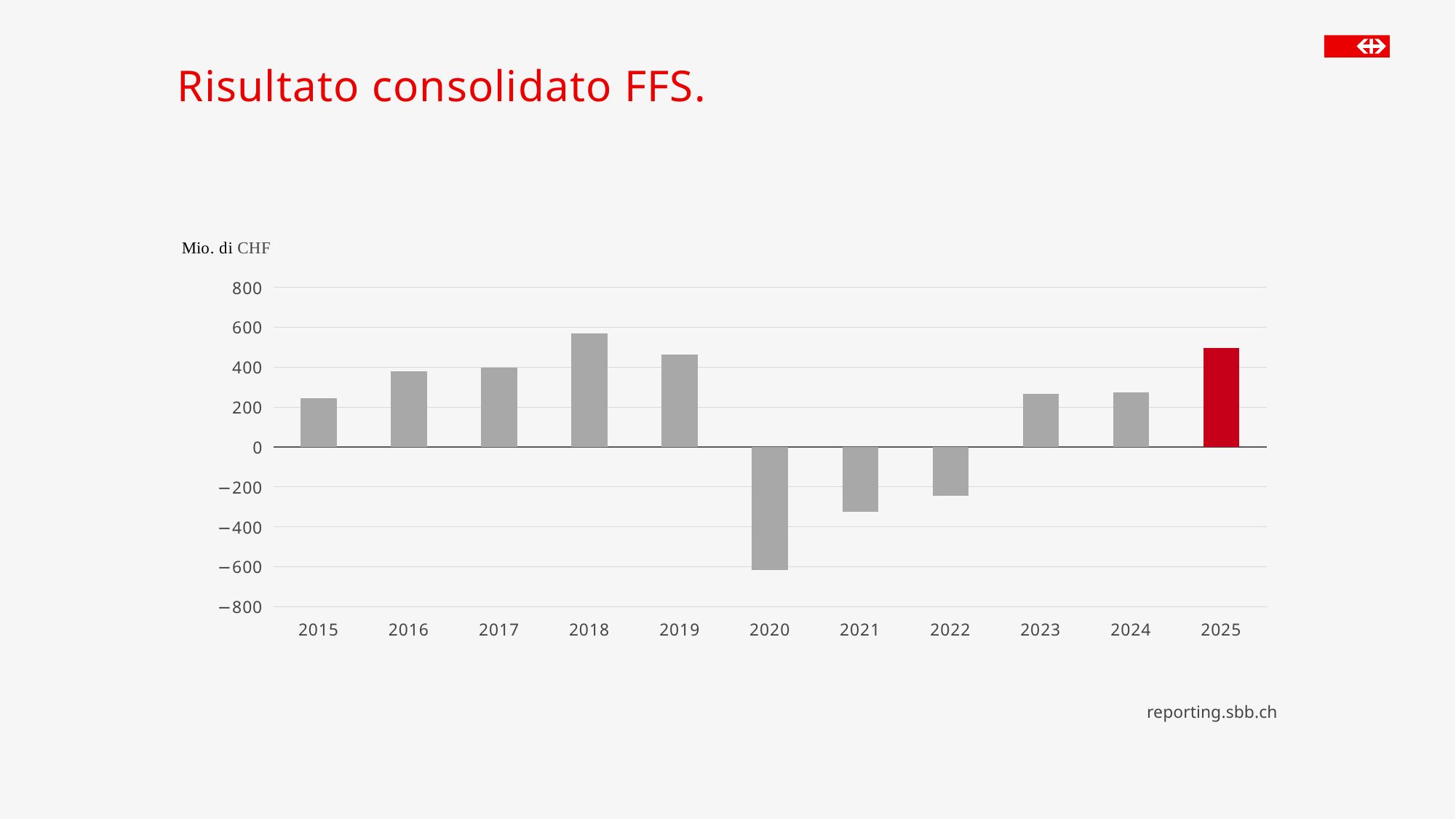
Which year has the highest value in the chart? 2018 What is the title of the slide? Risultato consolidato FFS. Is the value for 2020 greater or less than -400? less Which year has the lowest value in the chart? 2020 Is the value for 2018 greater or less than 400? greater Which year has the larger value, 2018 or 2019? 2018 How many years are shown on the x axis of the chart? 11 Is the value for 2021 greater or less than -200? less What kind of chart is shown on the slide? bar chart Which year's bar is coloured red in the chart? 2025 How many years in the chart have a negative value? 3